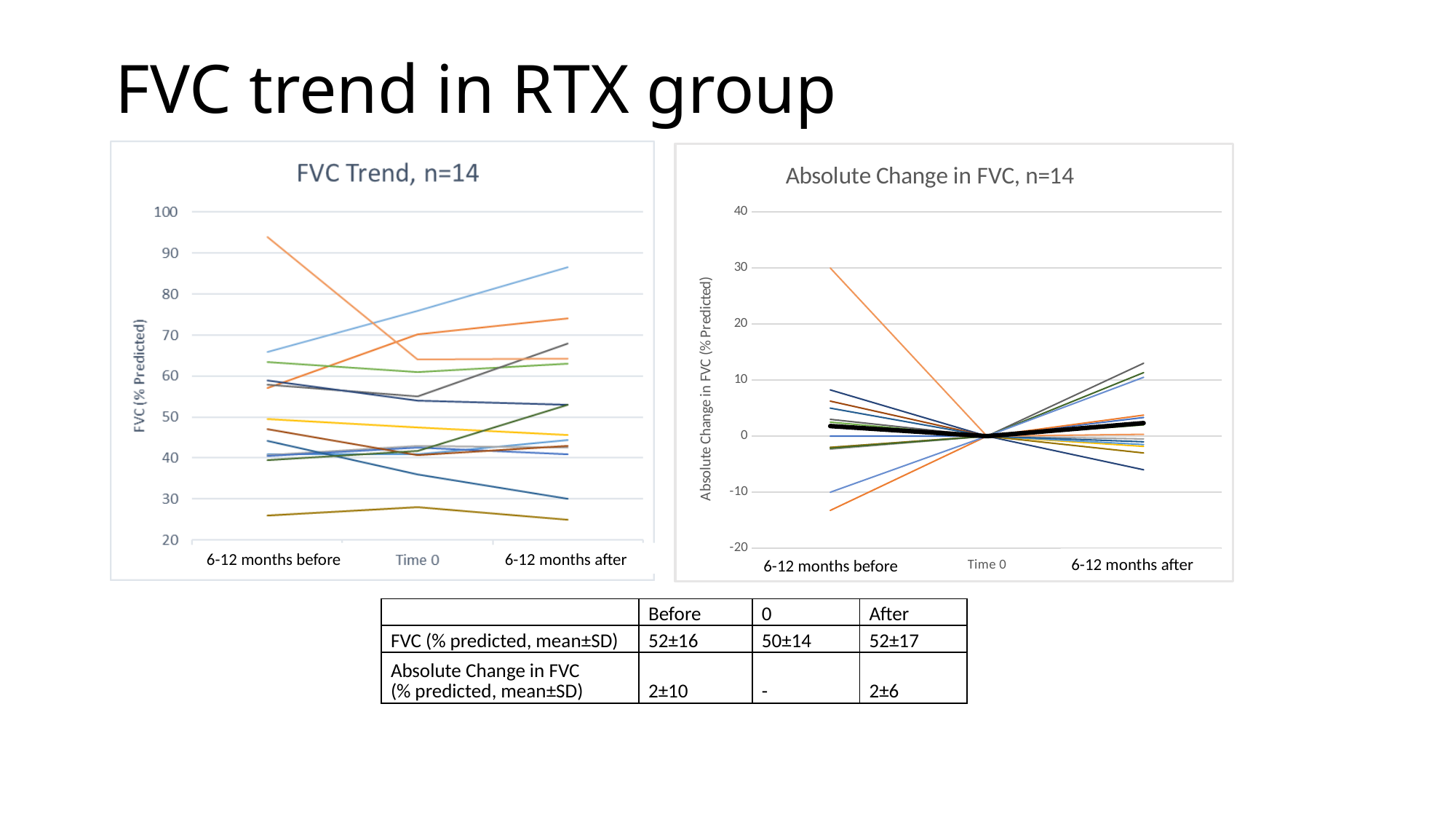
In the right chart "Absolute Change in FVC, n=14", is the highest value at "6-12 months after" greater or less than 10? greater In the right chart "Absolute Change in FVC, n=14", how many time points are shown on the x axis? 3 In the left chart "FVC Trend, n=14", is the highest value at "6-12 months after" greater or less than 80? greater What kind of chart is the left chart titled "FVC Trend, n=14"? line chart What is the title of the right chart on the slide? Absolute Change in FVC, n=14 In the left chart "FVC Trend, n=14", how many time points are shown on the x axis? 3 In the right chart "Absolute Change in FVC, n=14", is the lowest value at "6-12 months after" greater or less than 0? less What kind of chart is the right chart titled "Absolute Change in FVC, n=14"? line chart What is the y-axis label of the left chart "FVC Trend, n=14"? FVC (% Predicted)